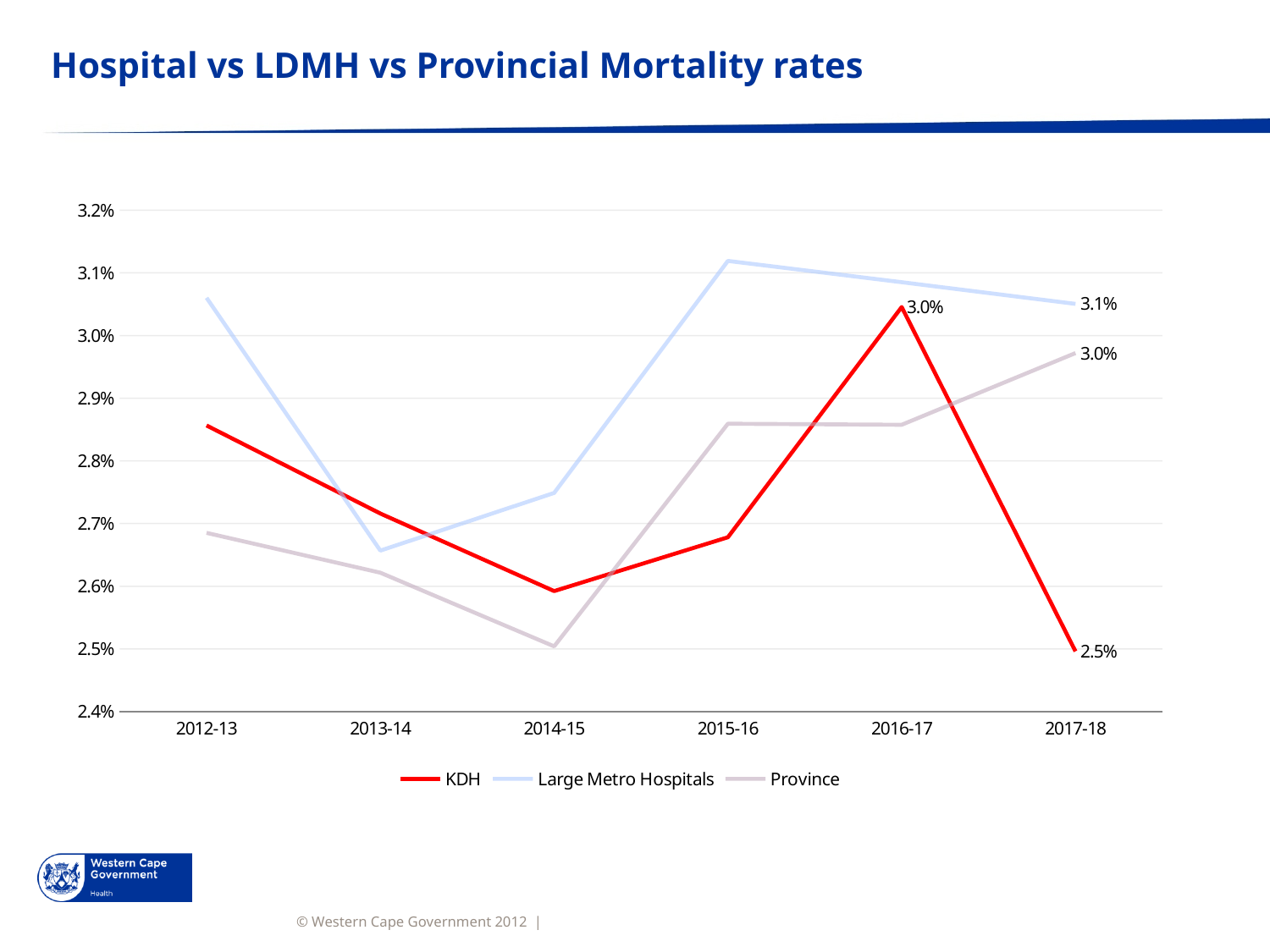
What is the KDH mortality rate for 2016-17? 3.0% How many series does the legend list? 3 What is the Province mortality rate for 2017-18? 3.0% In which year is the Province series at its lowest? 2014-15 What kind of chart is shown on the slide? line chart By how many percentage points did the KDH mortality rate fall from 2016-17 to 2017-18? 0.5% Which series has the highest value in 2012-13? Large Metro Hospitals What is the KDH mortality rate for 2017-18? 2.5% In 2017-18, which is higher: the KDH rate or the Large Metro Hospitals rate? Large Metro Hospitals Is the KDH value for 2014-15 greater or less than 2.7%? less How many years are shown on the x axis? 6 What is the Large Metro Hospitals mortality rate for 2017-18? 3.1%